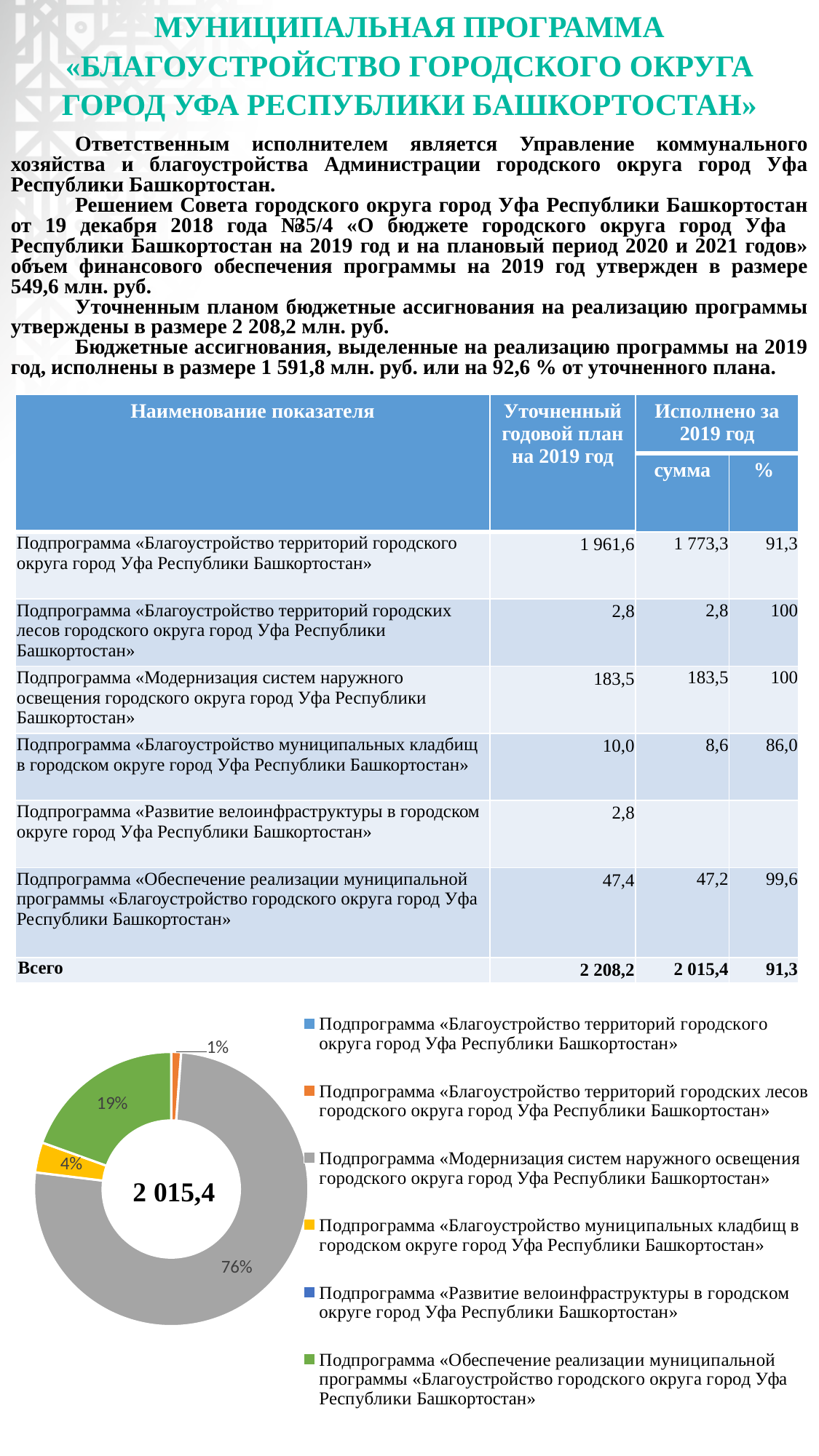
Which subprogram has the smallest labelled slice on the doughnut chart? Подпрограмма «Благоустройство территорий городских лесов городского округа город Уфа Республики Башкортостан» What kind of chart is shown at the bottom of the slide? Doughnut (pie) chart How many slices on the doughnut chart have a printed percentage label? 4 What is the difference in percentage points between the 76% slice and the 19% slice on the doughnut chart? 57 percentage points According to the legend, which subprogram corresponds to the 76% slice of the doughnut chart? Подпрограмма «Модернизация систем наружного освещения городского округа город Уфа Республики Башкортостан» What colour is the largest slice of the doughnut chart? Gray What value is printed in the centre of the doughnut chart? 2 015,4 How many entries does the legend of the doughnut chart list? 6 What share does the green slice (Подпрограмма «Обеспечение реализации муниципальной программы...») have on the doughnut chart? 19% What share does the yellow slice (Подпрограмма «Благоустройство муниципальных кладбищ...») have on the doughnut chart? 4% On the doughnut chart, which slice is larger: the green one (19%) or the yellow one (4%)? The green one (19%) What is the largest share shown on the doughnut chart? 76%